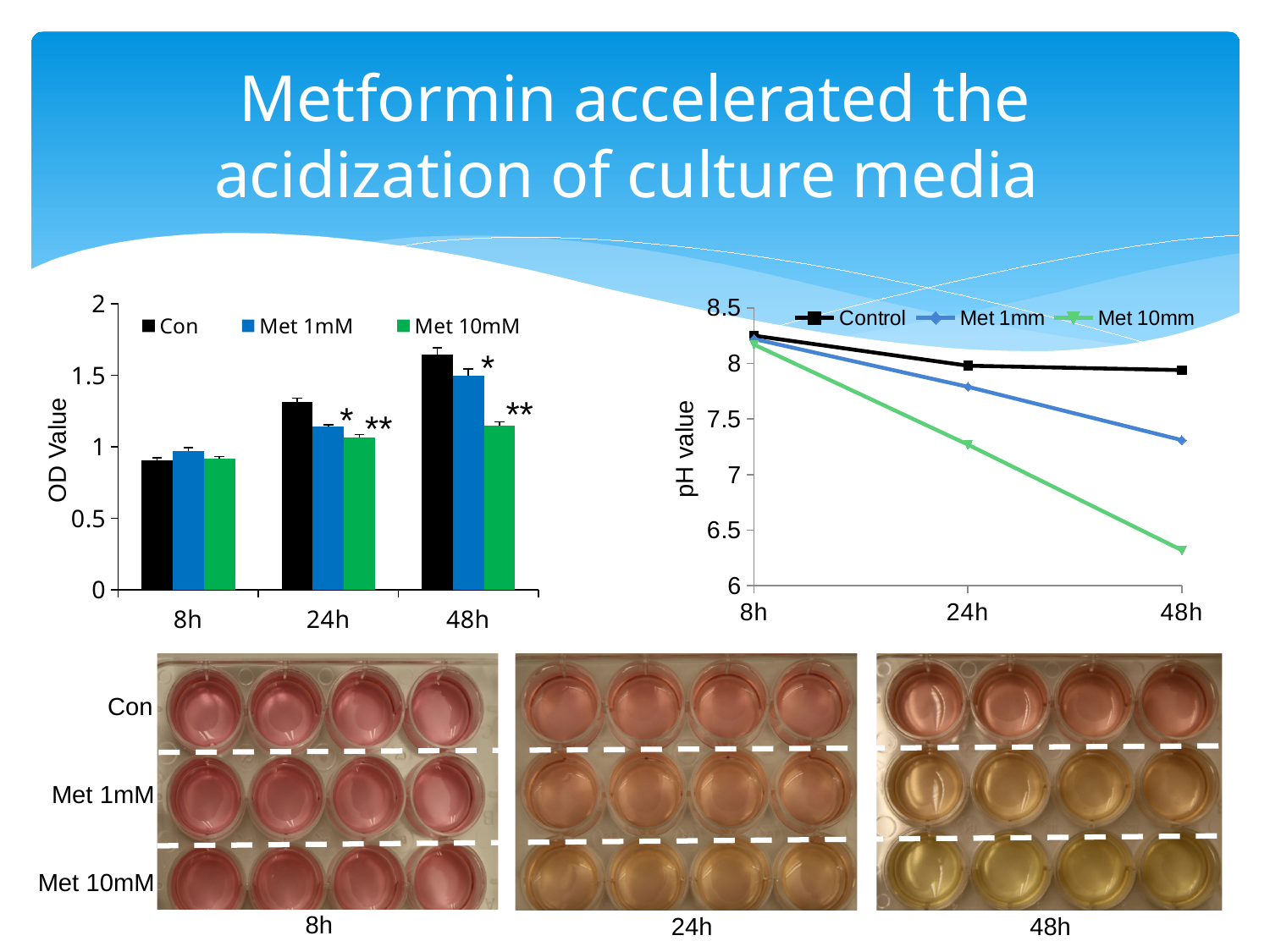
In the OD Value bar chart, how many time-point categories are shown on the x axis? 3 What kind of chart is the pH value chart on the right of the slide? line chart In the pH value line chart, how many series does the legend list? 3 In the OD Value bar chart, is the value for Con at 48h greater or less than 1.5? greater What kind of chart is the OD Value chart on the left of the slide? bar chart In the pH value line chart, is the value for Met 10mm at 48h greater or less than 6.5? less What is the y-axis label of the bar chart on the left of the slide? OD Value In the pH value line chart, does the Met 10mm line rise or fall from 8h to 48h? fall In the OD Value bar chart, how many series does the legend list? 3 In the OD Value bar chart, at 24h, which is larger: Con or Met 10mM? Con In the pH value line chart, which series has the lowest value at 48h? Met 10mm In the OD Value bar chart, which series has the highest value at 48h? Con